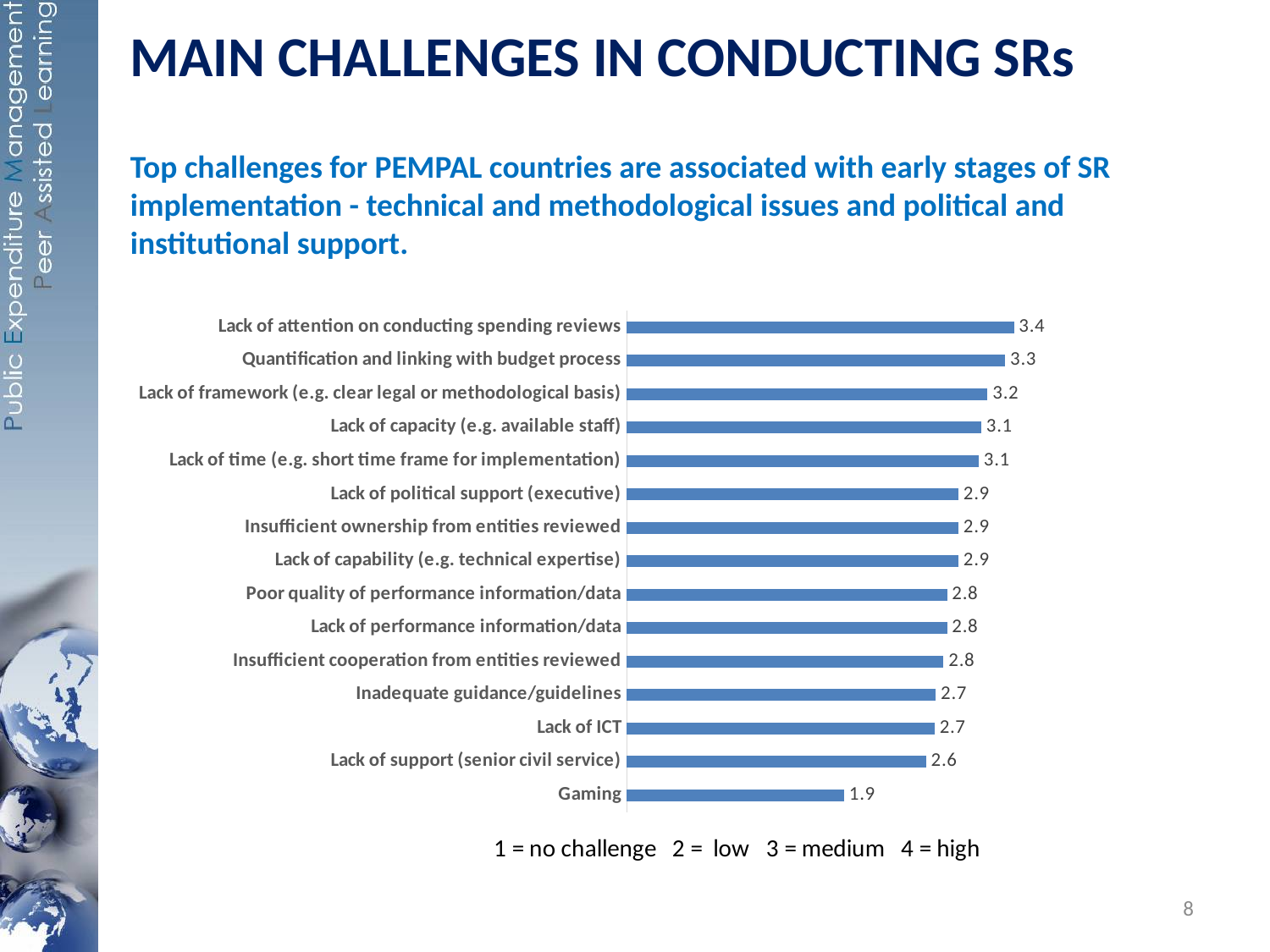
How many challenges are plotted in the chart? 15 What is the difference between the values for "Lack of attention on conducting spending reviews" and "Gaming"? 1.5 Which challenge has the lowest value? Gaming What kind of chart is shown on the slide? Bar chart Which challenge has the highest value? Lack of attention on conducting spending reviews What is the value for "Lack of attention on conducting spending reviews"? 3.4 Which is larger, the value for "Lack of framework (e.g. clear legal or methodological basis)" or the value for "Inadequate guidance/guidelines"? Lack of framework (e.g. clear legal or methodological basis) What is the value for "Gaming"? 1.9 What is the value for "Lack of political support (executive)"? 2.9 What is the value for "Lack of ICT"? 2.7 What is the difference between the values for "Quantification and linking with budget process" and "Lack of support (senior civil service)"? 0.7 According to the scale note below the chart, what does a value of 4 mean? high